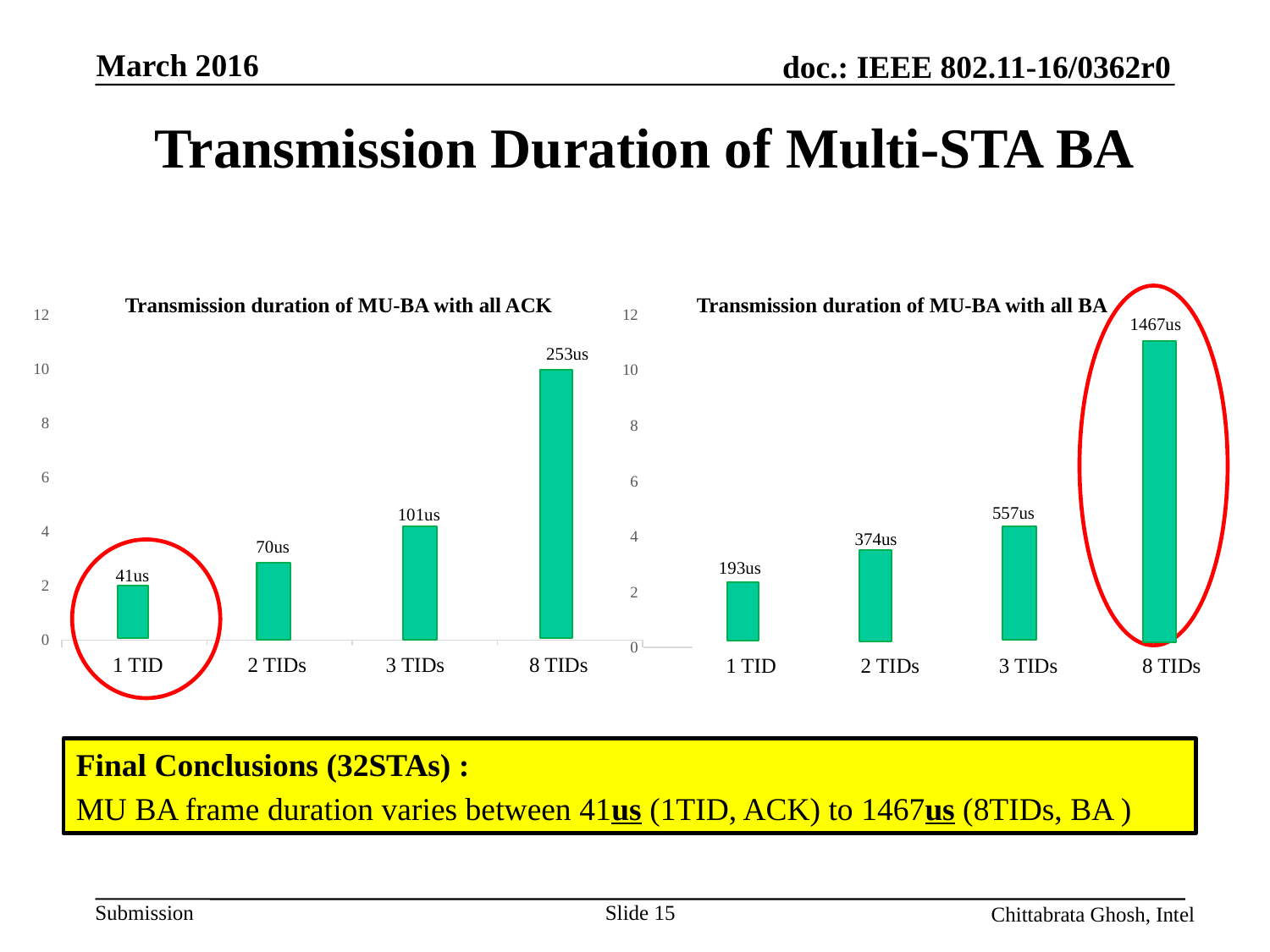
In the chart titled "Transmission duration of MU-BA with all BA", do the values rise or fall from 1 TID to 8 TIDs? Rise In the chart titled "Transmission duration of MU-BA with all ACK", what is the difference between the values for 8 TIDs and 1 TID? 212us In the chart titled "Transmission duration of MU-BA with all BA", what is the value for 2 TIDs? 374us In the chart titled "Transmission duration of MU-BA with all ACK", what is the value for 3 TIDs? 101us In the chart titled "Transmission duration of MU-BA with all ACK", which category has the highest value? 8 TIDs In the chart titled "Transmission duration of MU-BA with all BA", what is the difference between the values for 2 TIDs and 1 TID? 181us Which is larger: the value for 3 TIDs in the "all ACK" chart or the value for 1 TID in the "all BA" chart? 1 TID in the all BA chart In the chart titled "Transmission duration of MU-BA with all BA", which category has the lowest value? 1 TID In the chart titled "Transmission duration of MU-BA with all BA", what is the value for 8 TIDs? 1467us In the chart titled "Transmission duration of MU-BA with all ACK", what is the value for 1 TID? 41us What kind of chart is the chart titled "Transmission duration of MU-BA with all ACK"? Bar chart How many categories are shown in the chart titled "Transmission duration of MU-BA with all BA"? 4